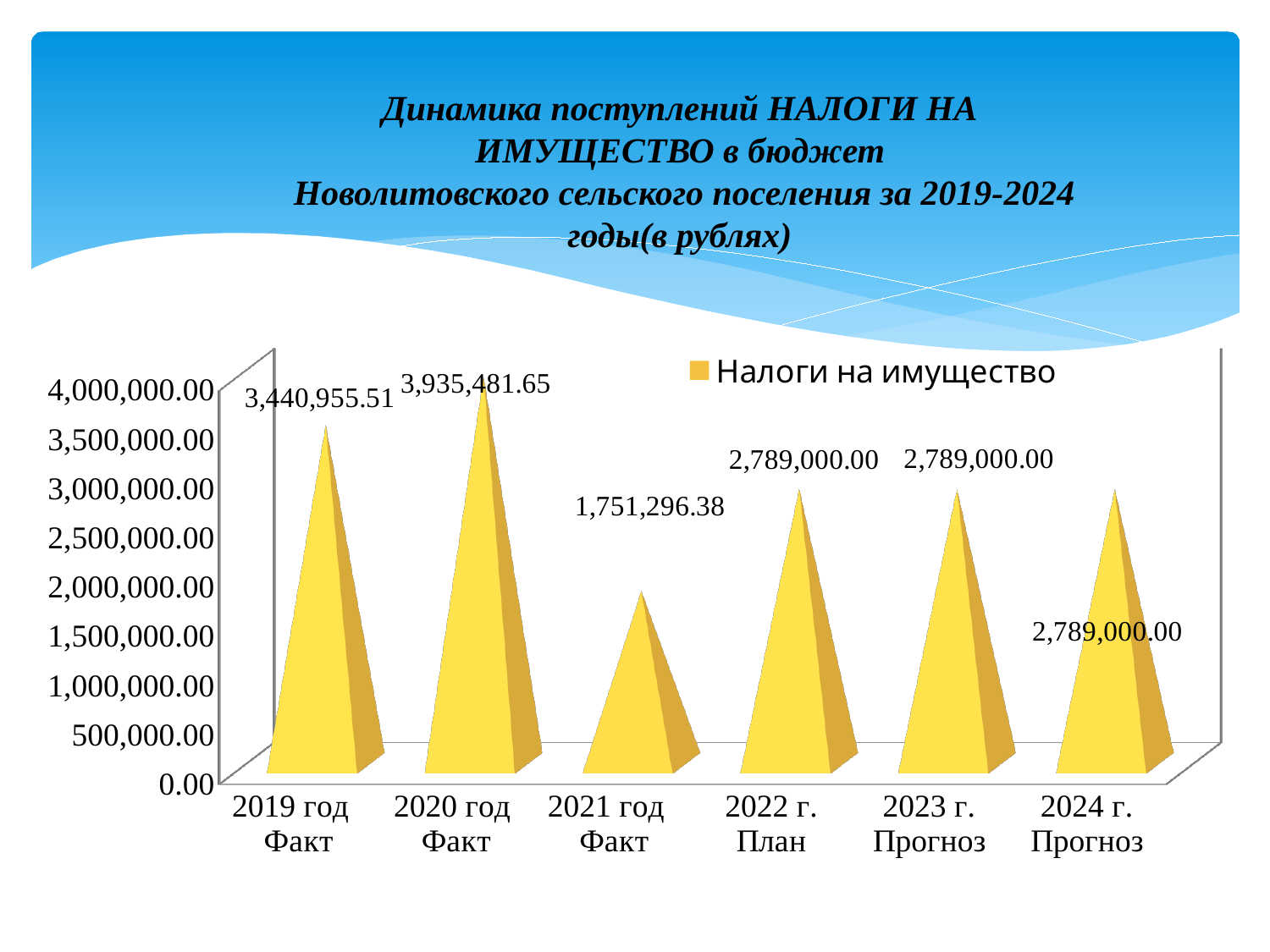
What is the difference between the values for 2022 г. План and 2021 год Факт? 1,037,703.62 How many categories are shown on the x axis? 6 Which is larger, the value for 2019 год Факт or the value for 2022 г. План? 2019 год Факт Which category has the lowest value? 2021 год Факт What is the value for 2021 год Факт? 1,751,296.38 How many series does the legend list? 1 What is the value for 2020 год Факт? 3,935,481.65 What is the name of the series shown in the legend? Налоги на имущество Which category has the highest value? 2020 год Факт What is the difference between the values for 2020 год Факт and 2019 год Факт? 494,526.14 What is the value for 2019 год Факт? 3,440,955.51 What is the value for 2023 г. Прогноз? 2,789,000.00